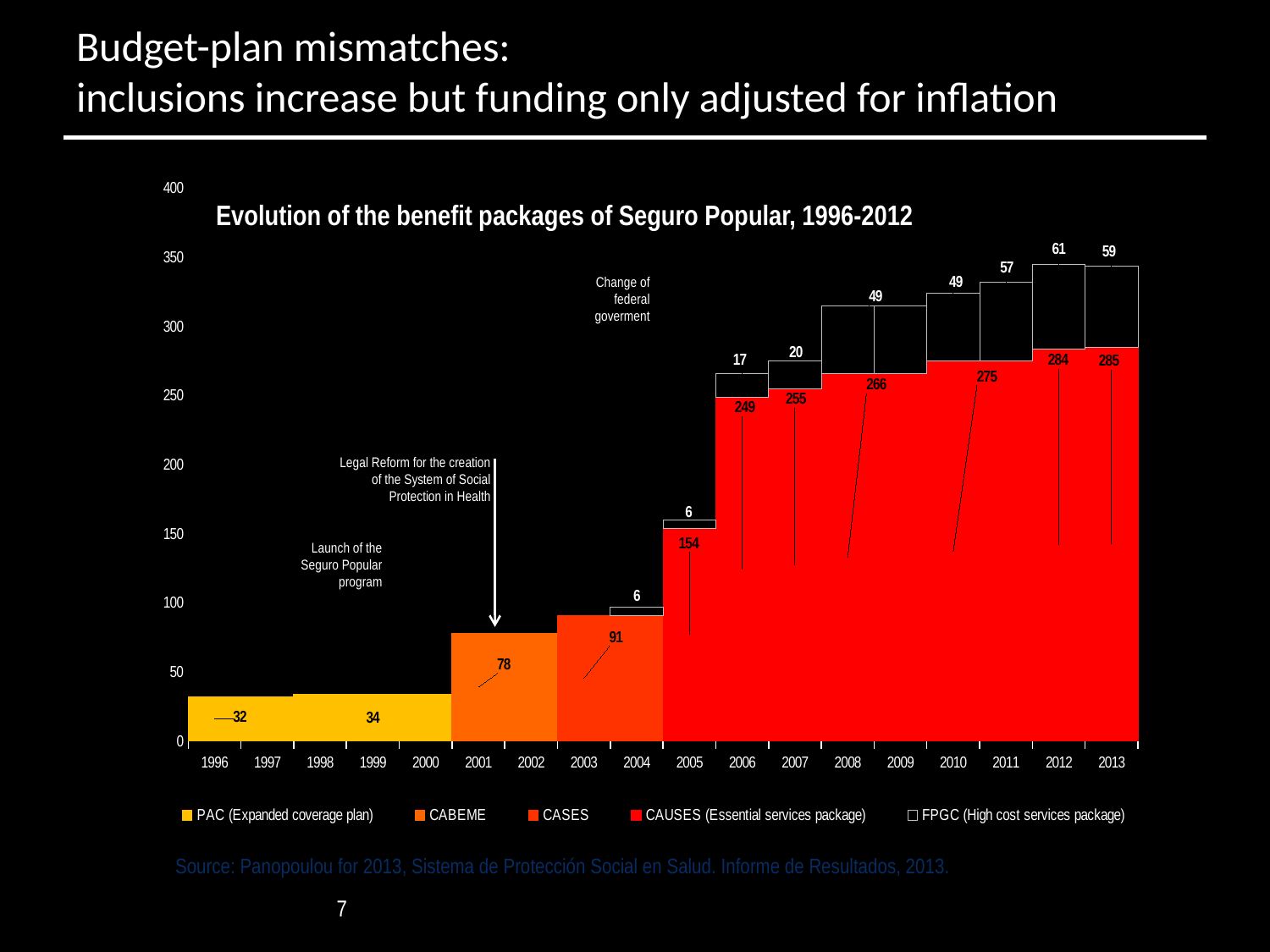
What is the value of the CABEME bar in 2001? 78 What is the value of the FPGC (High cost services package) segment in 2012? 61 What is the value of the CASES bar in 2003? 91 Do the bar totals generally rise or fall from 1996 to 2013? Rise What is the difference between the FPGC values in 2007 and 2006? 3 What is the title of the chart? Evolution of the benefit packages of Seguro Popular, 1996-2012 What is the value of the PAC (Expanded coverage plan) bar in 1996? 32 What is the total height of the stacked bar for 2012 (CAUSES plus FPGC)? 345 Which is larger, the CAUSES value in 2006 or in 2007? 2007 What kind of chart is shown on the slide? Stacked bar chart How many series does the legend list? 5 What is the value of the CAUSES (Essential services package) segment in 2005? 154